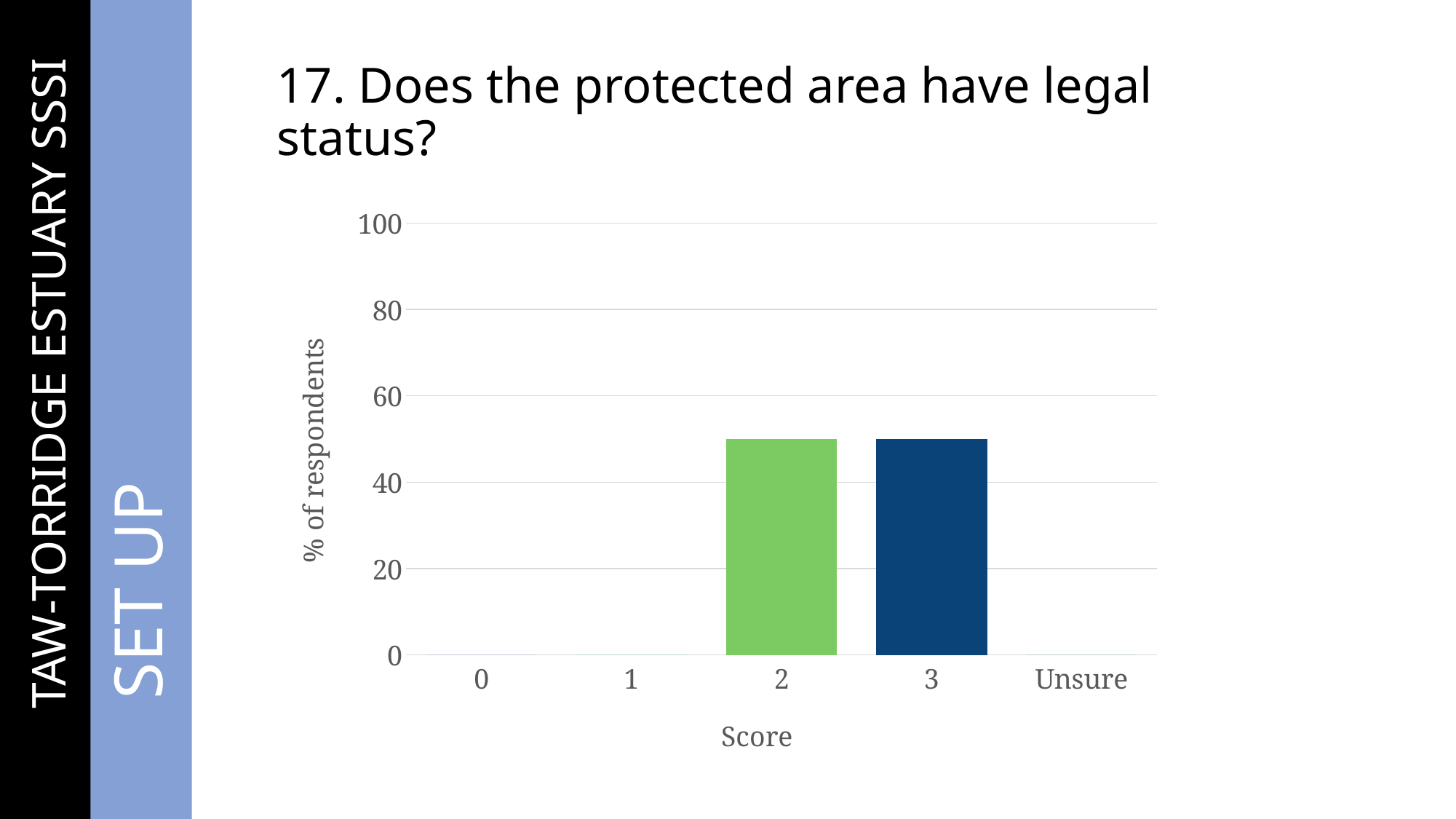
Which has the larger value, score 3 or Unsure? 3 Is the value for score 2 greater or less than 60? less Is the value for score 3 greater or less than 60? less Which has the larger value, score 1 or score 2? 2 How many categories on the chart have a visible bar? 2 What is the title of the chart's y axis? % of respondents What is the title of the chart's x axis? Score Is the value for score 2 greater or less than 40? greater How many categories are shown on the x axis of the chart? 5 What kind of chart is shown on the slide? bar chart